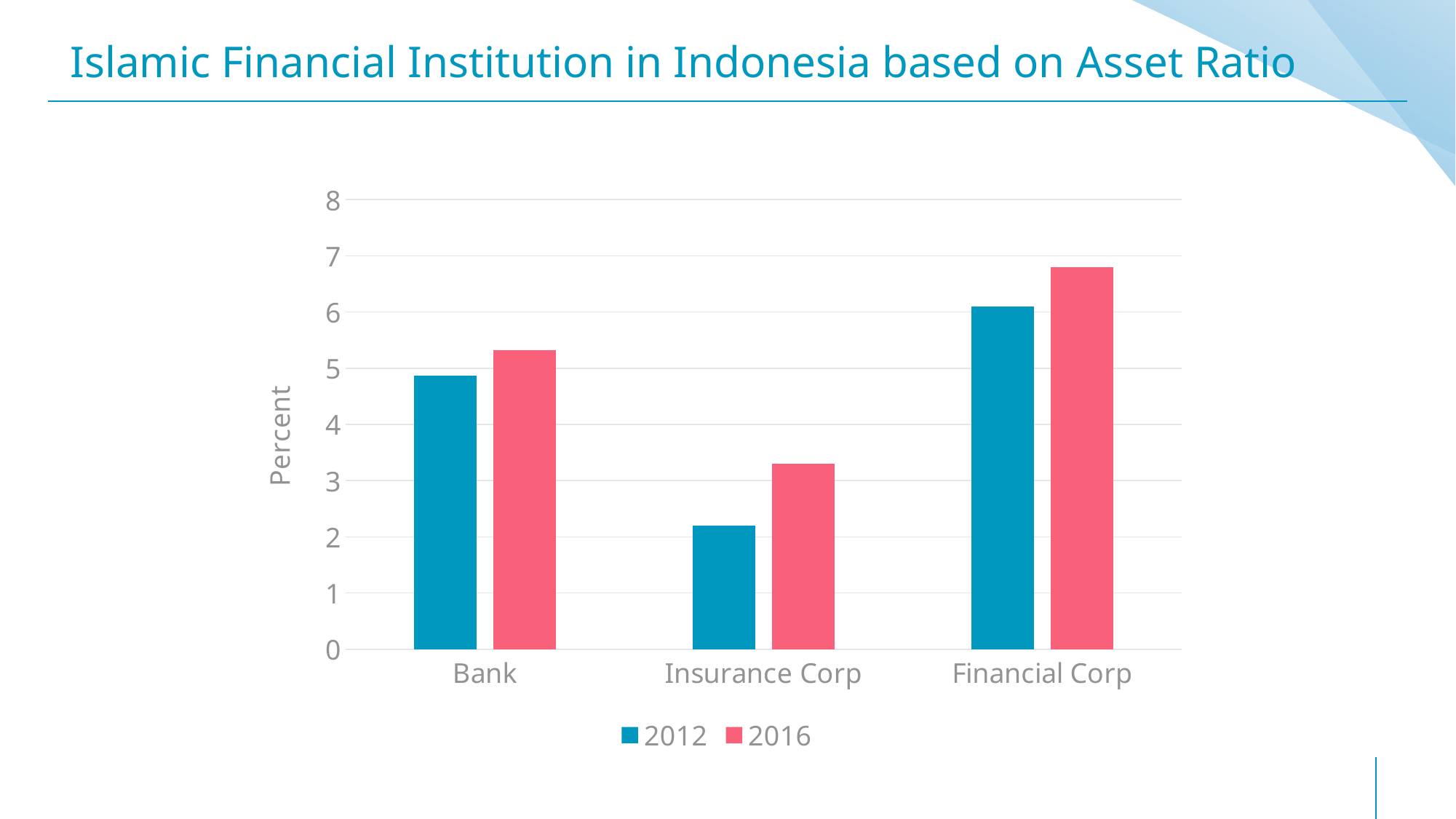
Is the value for Insurance Corp in 2012 greater or less than 3? less How many series does the chart's legend list? 2 What is the label on the vertical axis of the chart? Percent Which is larger in 2012, the value for Bank or the value for Financial Corp? Financial Corp Is the value for Bank in 2016 greater or less than 5? greater Which category has the lowest value for 2012? Insurance Corp Is the value for Financial Corp in 2016 greater or less than 6? greater Which category has the highest value for 2016? Financial Corp Which is larger for Insurance Corp, the 2012 value or the 2016 value? 2016 What is the title of the chart? Islamic Financial Institution in Indonesia based on Asset Ratio What type of chart is shown on the slide? Bar chart How many categories are shown on the x axis of the chart? 3